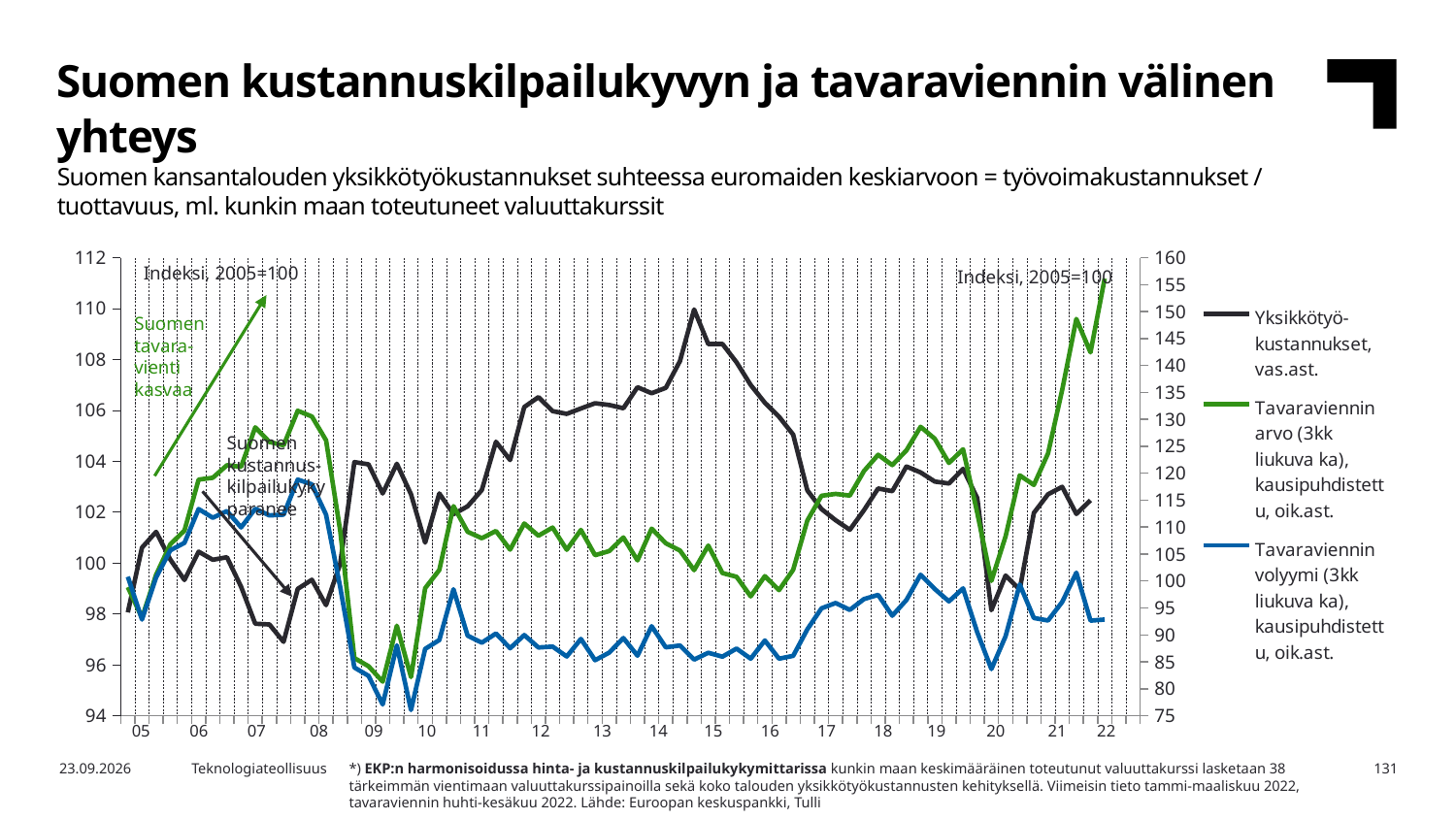
Does the Tavaraviennin arvo line rise or fall from 2020 to 2022? rise Is the value of the Tavaraviennin volyymi line at its 2020 dip greater or less than 90 on the right axis? less Which series is plotted on the left axis (vas.ast.) according to the legend? Yksikkötyökustannukset Is the lowest value of the Tavaraviennin volyymi line around 2009 greater or less than 85 on the right axis? less How many year labels are shown on the x axis? 18 Is the value of the Tavaraviennin arvo line at the end of 2022 greater or less than 150 on the right axis? greater How many series does the legend list? 3 What kind of chart is shown on the slide? line chart Does the Yksikkötyökustannukset line rise or fall between its 2014–2015 peak and 2017? fall What index base is stated in the chart annotations? Indeksi, 2005=100 At the end of 2022, which is higher on the right axis: Tavaraviennin arvo or Tavaraviennin volyymi? Tavaraviennin arvo